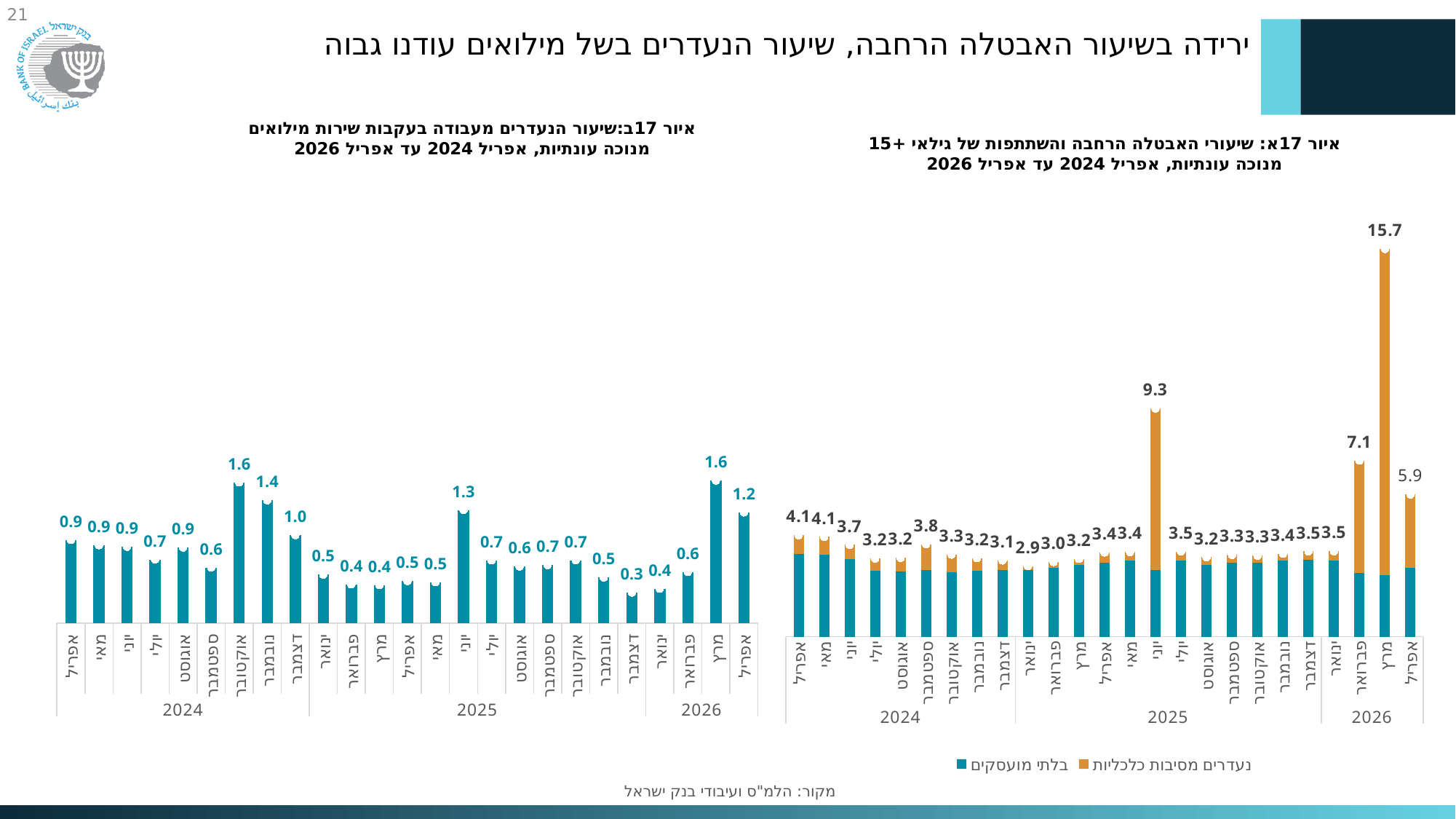
In the left chart (Figure 17b), what is the difference between the values for March 2026 and April 2026? 0.4 In the right chart (Figure 17a), what is the total labelled for March 2026? 15.7 In the left chart (Figure 17b), which is larger: the value for June 2025 or the value for November 2024? November 2024 In the left chart (Figure 17b), what is the value for December 2025? 0.3 What kind of chart is the right chart (Figure 17a)? Stacked bar chart In the left chart (Figure 17b), what is the value for October 2024? 1.6 How many monthly bars are plotted in the left chart (Figure 17b)? 25 In the right chart (Figure 17a), which month has the highest total? March 2026 How many series does the legend of the right chart (Figure 17a) list? 2 In the right chart (Figure 17a), what is the difference between the totals for June 2025 and July 2025? 5.8 In the right chart (Figure 17a), which month has the lowest total? January 2025 In the left chart (Figure 17b), which month has the lowest value? December 2025